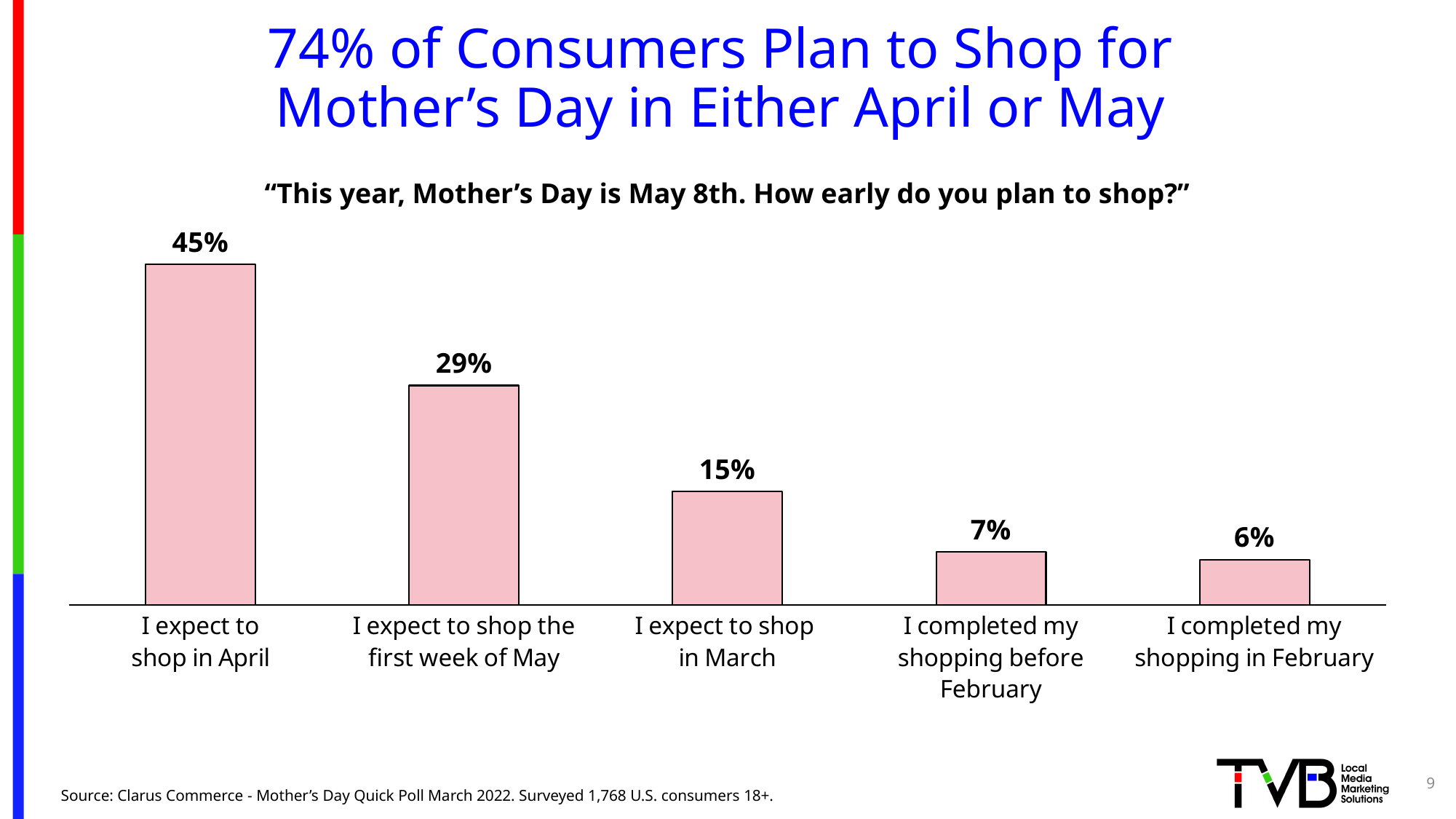
What is the difference in percentage points between "I expect to shop in April" and "I expect to shop the first week of May"? 16 What percentage of consumers said "I expect to shop in April"? 45% What percentage of consumers said "I expect to shop the first week of May"? 29% How many response categories are shown in the chart? 5 Do the values rise or fall moving from left to right across the categories? Fall What is the combined percentage for "I expect to shop in April" and "I expect to shop the first week of May"? 74% What percentage of consumers said "I completed my shopping in February"? 6% What survey question is shown above the chart? "This year, Mother's Day is May 8th. How early do you plan to shop?" Which response has the lowest percentage? I completed my shopping in February Which response has the highest percentage? I expect to shop in April Which is larger: the value for "I expect to shop in March" or the value for "I completed my shopping before February"? I expect to shop in March What kind of chart is shown on the slide? Bar chart